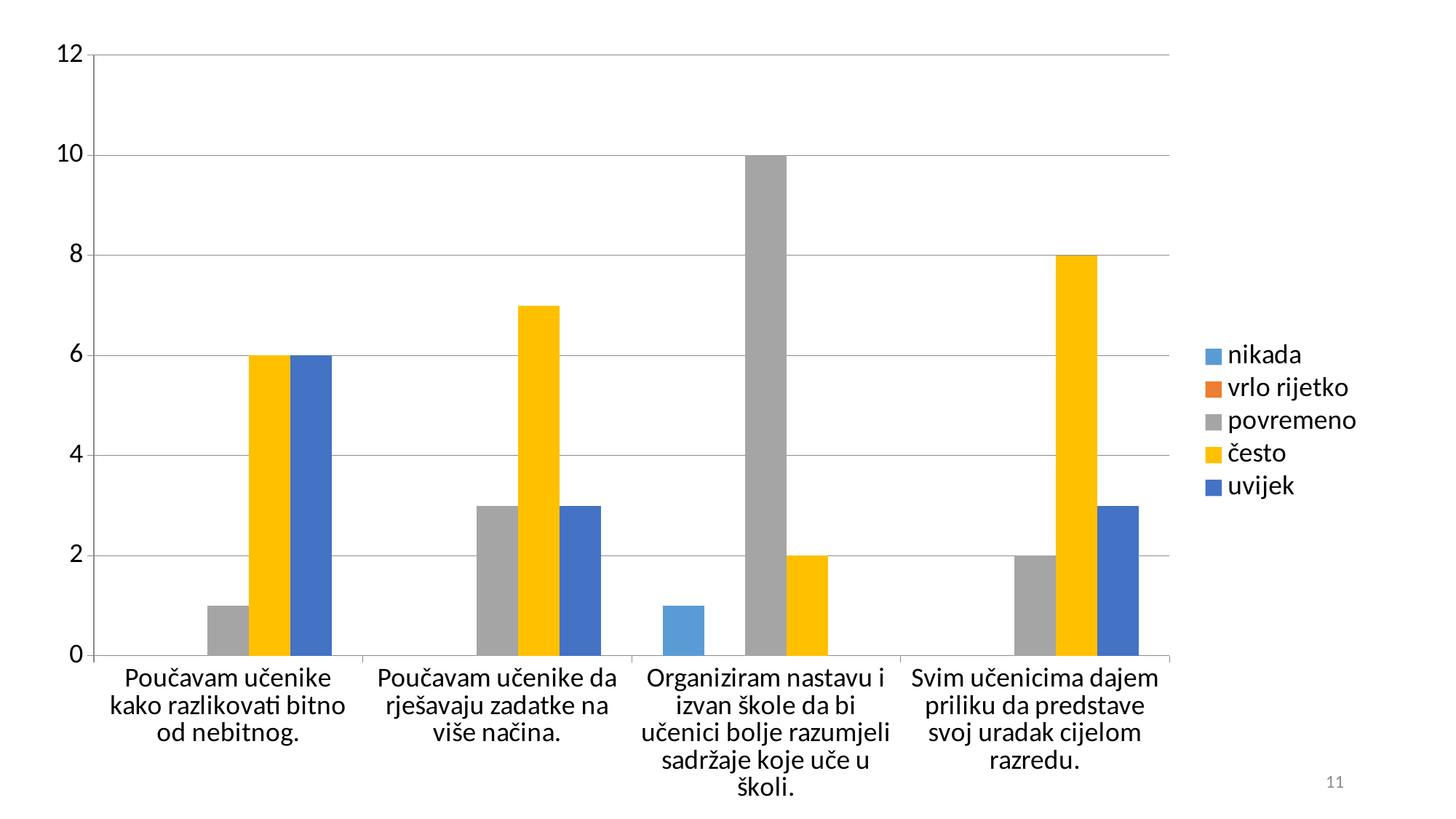
What is the value of 'uvijek' for 'Poučavam učenike kako razlikovati bitno od nebitnog.'? 6 What is the value of 'povremeno' for 'Organiziram nastavu i izvan škole da bi učenici bolje razumjeli sadržaje koje uče u školi.'? 10 What is the value of 'često' for 'Poučavam učenike kako razlikovati bitno od nebitnog.'? 6 How many categories are shown on the x axis? 4 How many series does the legend list? 5 What is the value of 'često' for 'Svim učenicima dajem priliku da predstave svoj uradak cijelom razredu.'? 8 What kind of chart is shown on the slide? bar chart What is the value of 'često' for 'Organiziram nastavu i izvan škole da bi učenici bolje razumjeli sadržaje koje uče u školi.'? 2 Which category has the highest 'povremeno' value? Organiziram nastavu i izvan škole da bi učenici bolje razumjeli sadržaje koje uče u školi. Is the value of 'često' for 'Poučavam učenike da rješavaju zadatke na više načina.' greater or less than 6? greater What is the difference between the 'povremeno' value for 'Organiziram nastavu i izvan škole...' and the 'često' value for 'Svim učenicima dajem priliku...'? 2 Which is larger for 'Svim učenicima dajem priliku da predstave svoj uradak cijelom razredu.': 'često' or 'uvijek'? često